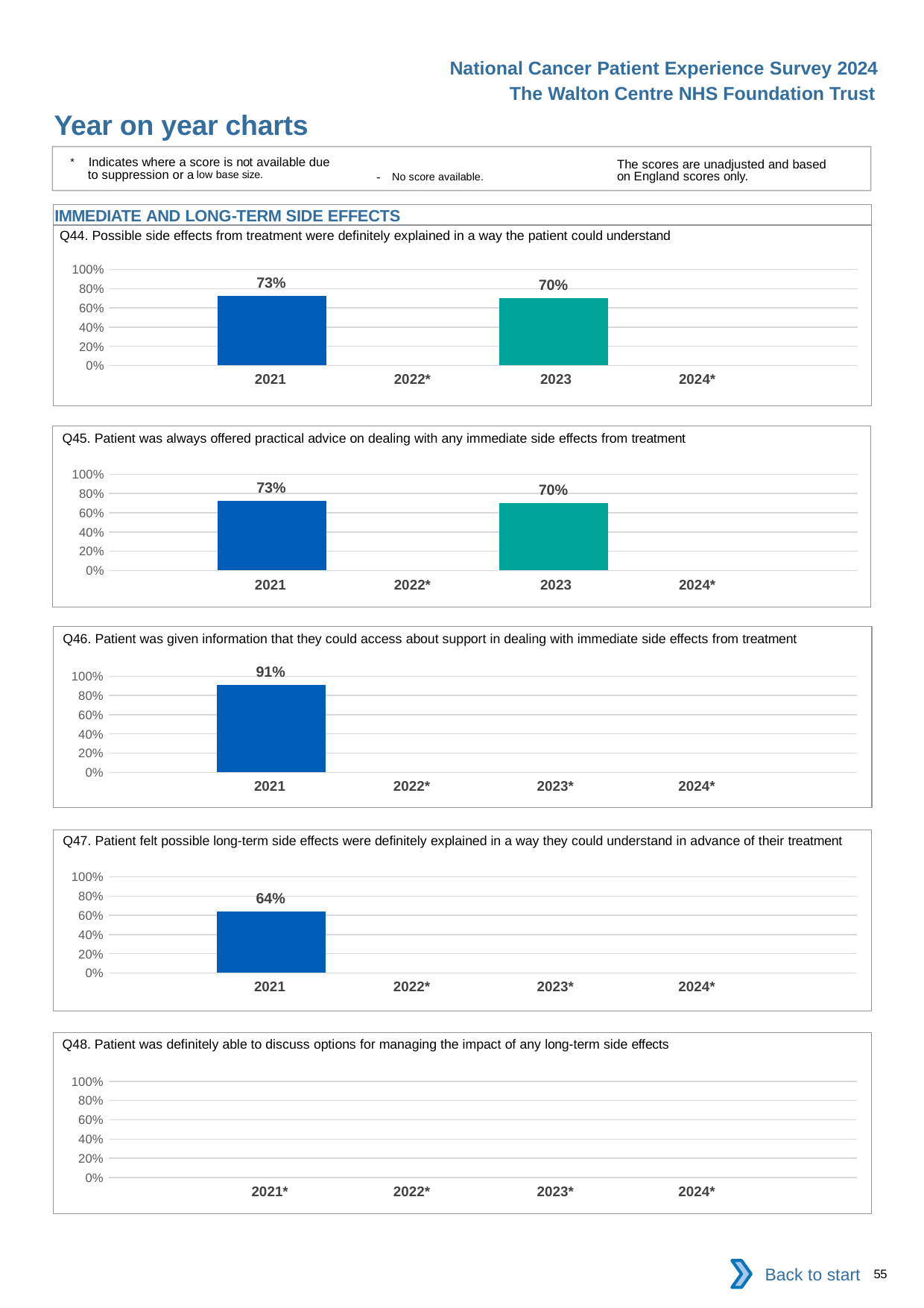
In the Q45 chart, how many years have a bar plotted? 2 In the Q44 chart, what is the value for 2021? 73% In the Q46 chart, what is the value for 2021? 91% In the Q44 chart, which year has the higher value, 2021 or 2023? 2021 In the Q46 chart, is the value for 2021 greater or less than 80%? greater In the Q45 chart, what is the value for 2023? 70% What kind of chart is the Q44 chart? Bar chart In the Q48 chart, how many bars are plotted? 0 In the Q47 chart, is the value for 2021 greater or less than 60%? greater In the Q47 chart, what is the value for 2021? 64% In the Q44 chart, what is the value for 2023? 70% In the Q44 chart, what is the difference between the 2021 and 2023 values? 3 percentage points